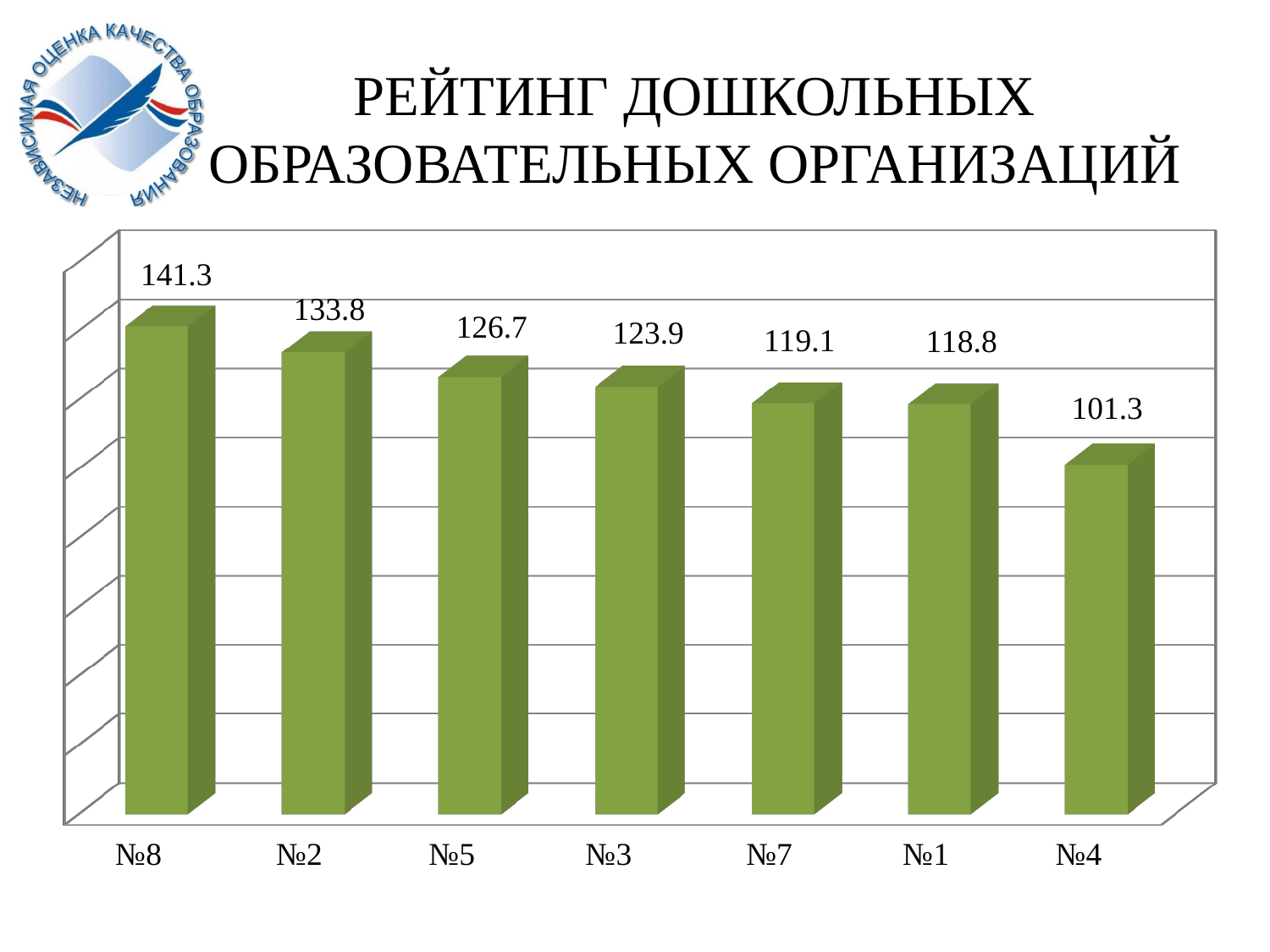
What is the value for №7? 119.1 What is the difference between the values for №2 and №5? 7.1 What is the value for №3? 123.9 Which category has the highest value? №8 What is the value for №4? 101.3 How many categories are shown in the chart? 7 Do the values rise or fall from left to right along the x axis? Fall What is the difference between the values for №8 and №4? 40 Which has a larger value, №5 or №1? №5 What is the value for №8? 141.3 What kind of chart is shown on the slide? Bar chart Which category has the lowest value? №4